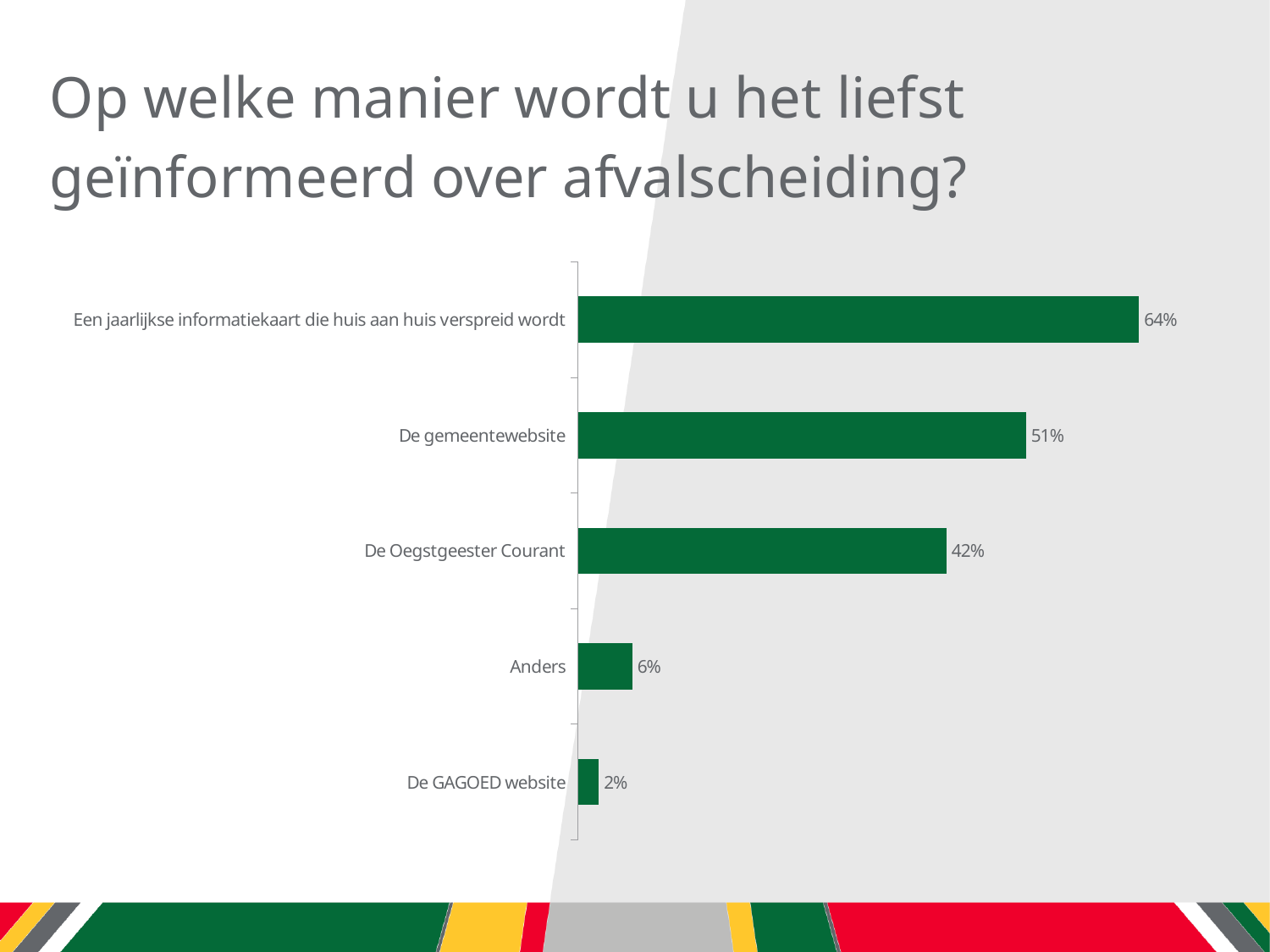
Which category has the highest value? Een jaarlijkse informatiekaart die huis aan huis verspreid wordt What is the difference between the values for 'De gemeentewebsite' and 'De Oegstgeester Courant'? 9% What is the value for 'Een jaarlijkse informatiekaart die huis aan huis verspreid wordt'? 64% Which category has the lowest value? De GAGOED website How many categories are shown in the chart? 5 Which is larger, the value for 'Anders' or the value for 'De GAGOED website'? Anders What is the difference between the values for 'Een jaarlijkse informatiekaart die huis aan huis verspreid wordt' and 'De GAGOED website'? 62% What kind of chart is shown on the slide? Bar chart What is the value for 'De gemeentewebsite'? 51% What is the value for 'De Oegstgeester Courant'? 42% What is the value for 'Anders'? 6% What is the value for 'De GAGOED website'? 2%